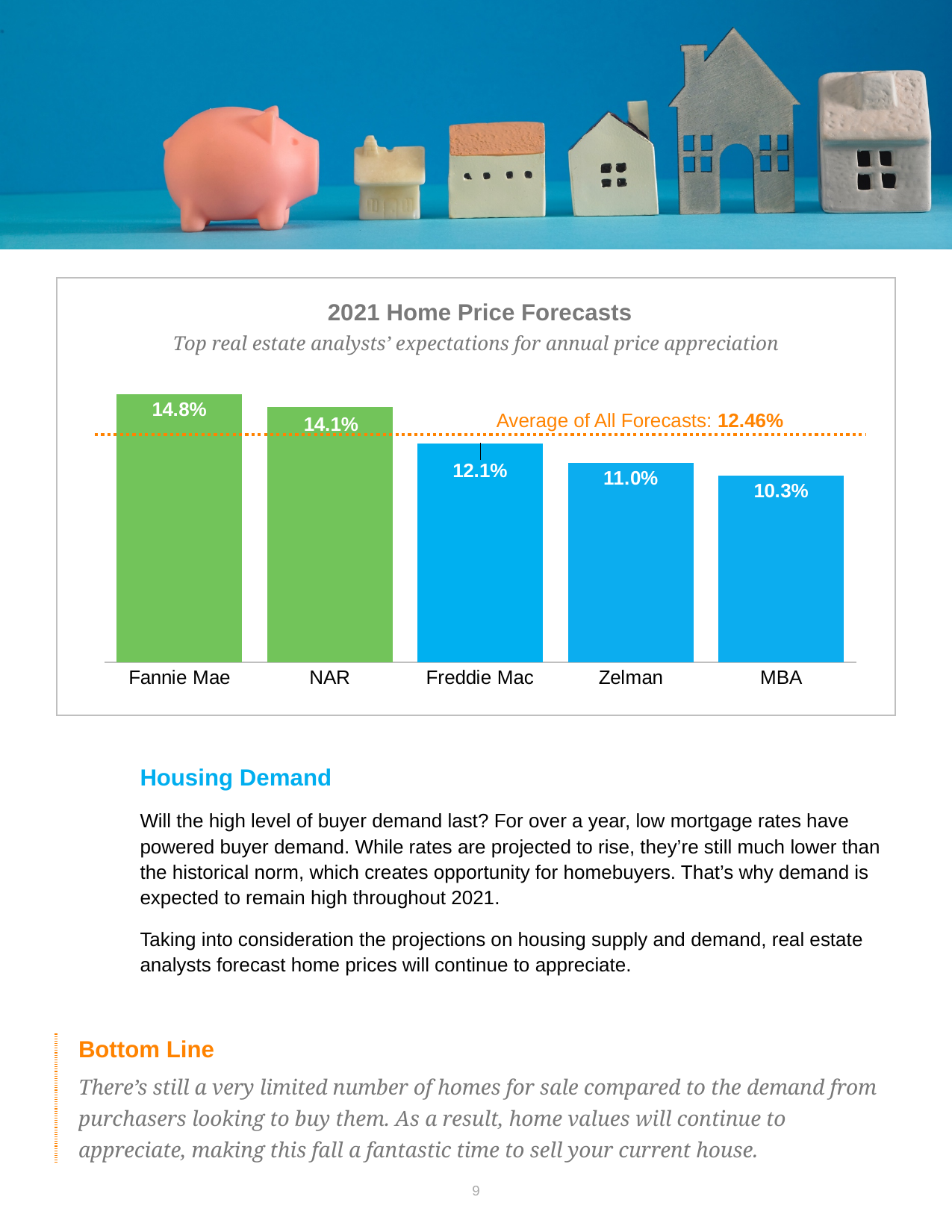
What is the difference between the Fannie Mae and NAR forecasts? 0.7% How many analysts are shown in the chart? 5 What is the 2021 home price forecast for Zelman? 11.0% What kind of chart is shown on the slide? Bar chart What is the average of all forecasts shown on the chart? 12.46% What is the 2021 home price forecast for Fannie Mae? 14.8% Which analyst has the lowest 2021 home price forecast? MBA Do the forecast values rise or fall from left to right across the chart? Fall Which analyst has the highest 2021 home price forecast? Fannie Mae What is the 2021 home price forecast for MBA? 10.3% What is the difference between the Freddie Mac and MBA forecasts? 1.8% Which forecast is larger, NAR or Freddie Mac? NAR